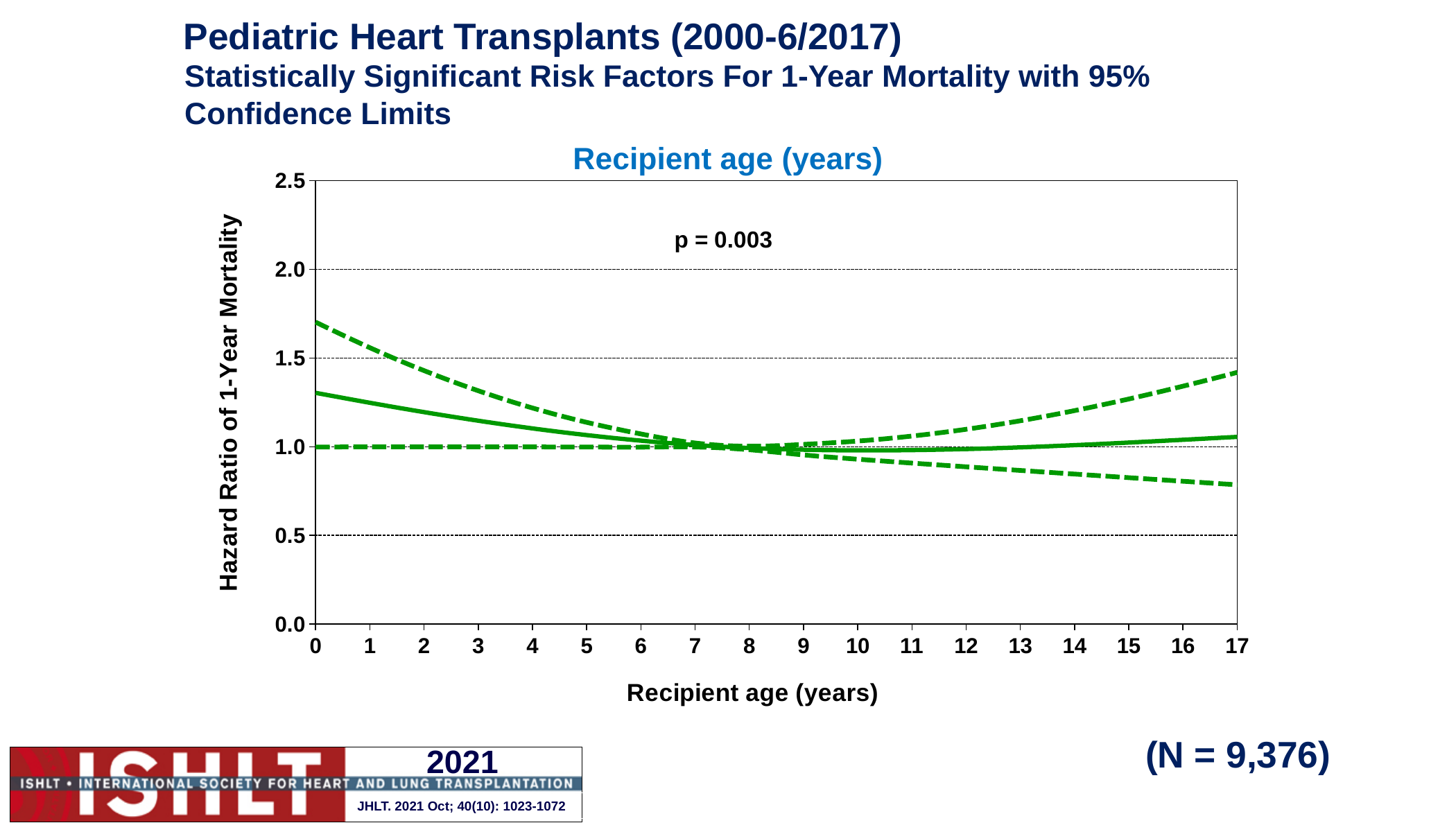
What kind of chart is shown on the slide? line chart What is the highest value shown on the y axis? 2.5 Does the solid hazard ratio line rise or fall between recipient age 0 and recipient age 8? fall What sample size (N) is printed on the slide? N = 9,376 Does the upper dashed confidence limit rise or fall between recipient age 9 and recipient age 17? rise What is the label of the y axis? Hazard Ratio of 1-Year Mortality What is the title of the chart? Recipient age (years) Is the upper dashed confidence limit at recipient age 0 greater or less than 1.5? greater Is the hazard ratio of the solid line at recipient age 0 greater or less than 1.0? greater What p-value is printed on the chart? p = 0.003 Is the upper dashed confidence limit at recipient age 17 greater or less than 2.0? less